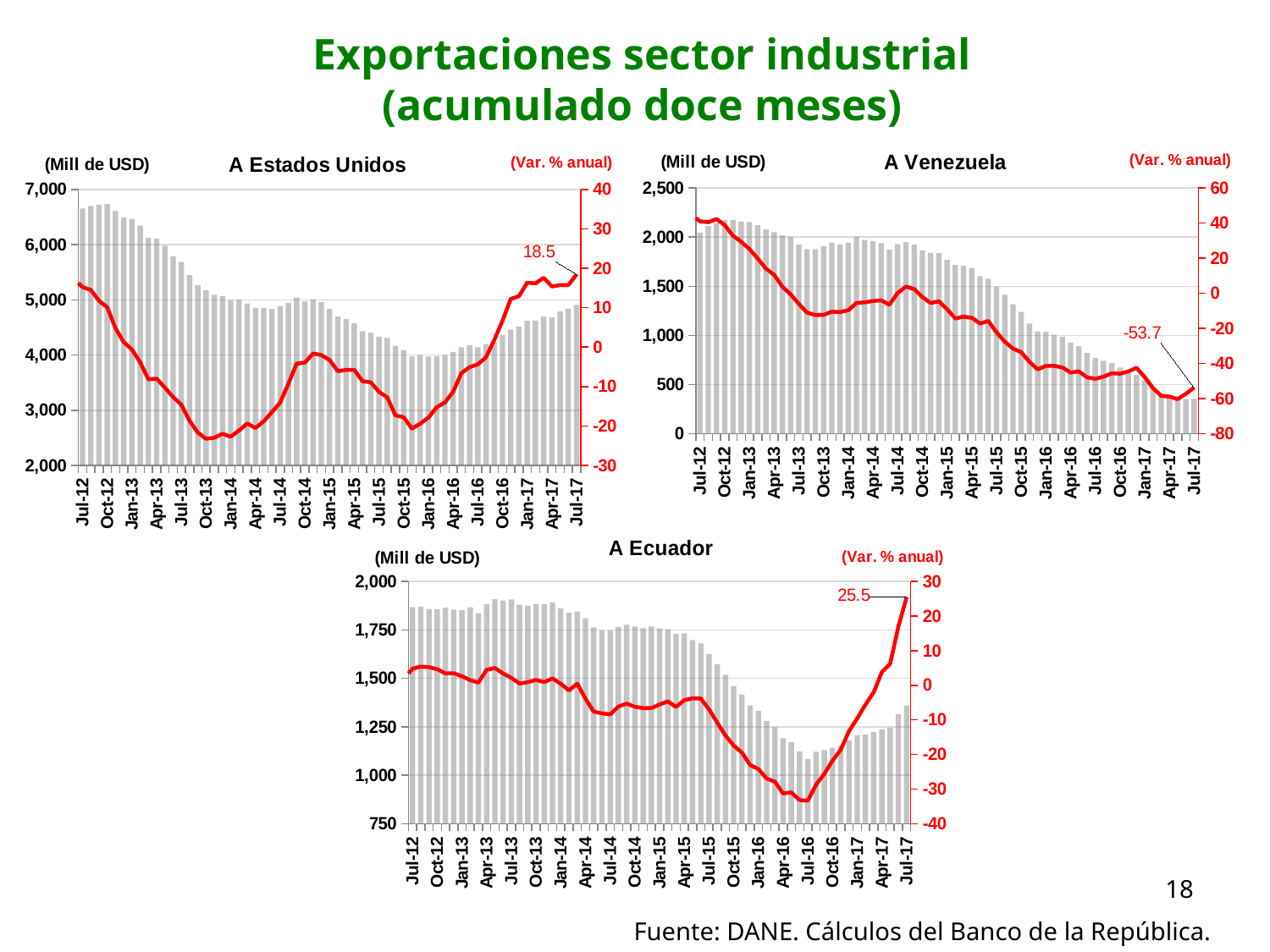
In the chart 'A Ecuador', what annual % variation is labeled for Jul-17? 25.5 In the chart 'A Venezuela', is the bar value for Jul-17 greater or less than 500? less What does the red line represent in each chart, according to the label above the right axis? Var. % anual What is the difference between the labeled Jul-17 annual variation in 'A Ecuador' (25.5) and in 'A Estados Unidos' (18.5)? 7.0 In the chart 'A Estados Unidos', is the bar value for Oct-12 greater or less than 6,000? greater In the chart 'A Ecuador', at which month does the red line reach its highest point? Jul-17 In the chart 'A Venezuela', what annual % variation is labeled for Jul-17? -53.7 In the chart 'A Venezuela', do the bar values rise or fall from Jul-12 to Jul-17? fall Comparing the labeled Jul-17 annual variations, which chart shows the highest value? A Ecuador In the chart 'A Ecuador', is the bar value for Jul-16 greater or less than 1,250? less What kind of chart is 'A Ecuador'? bar and line chart In the chart 'A Estados Unidos', what annual % variation is labeled for Jul-17? 18.5